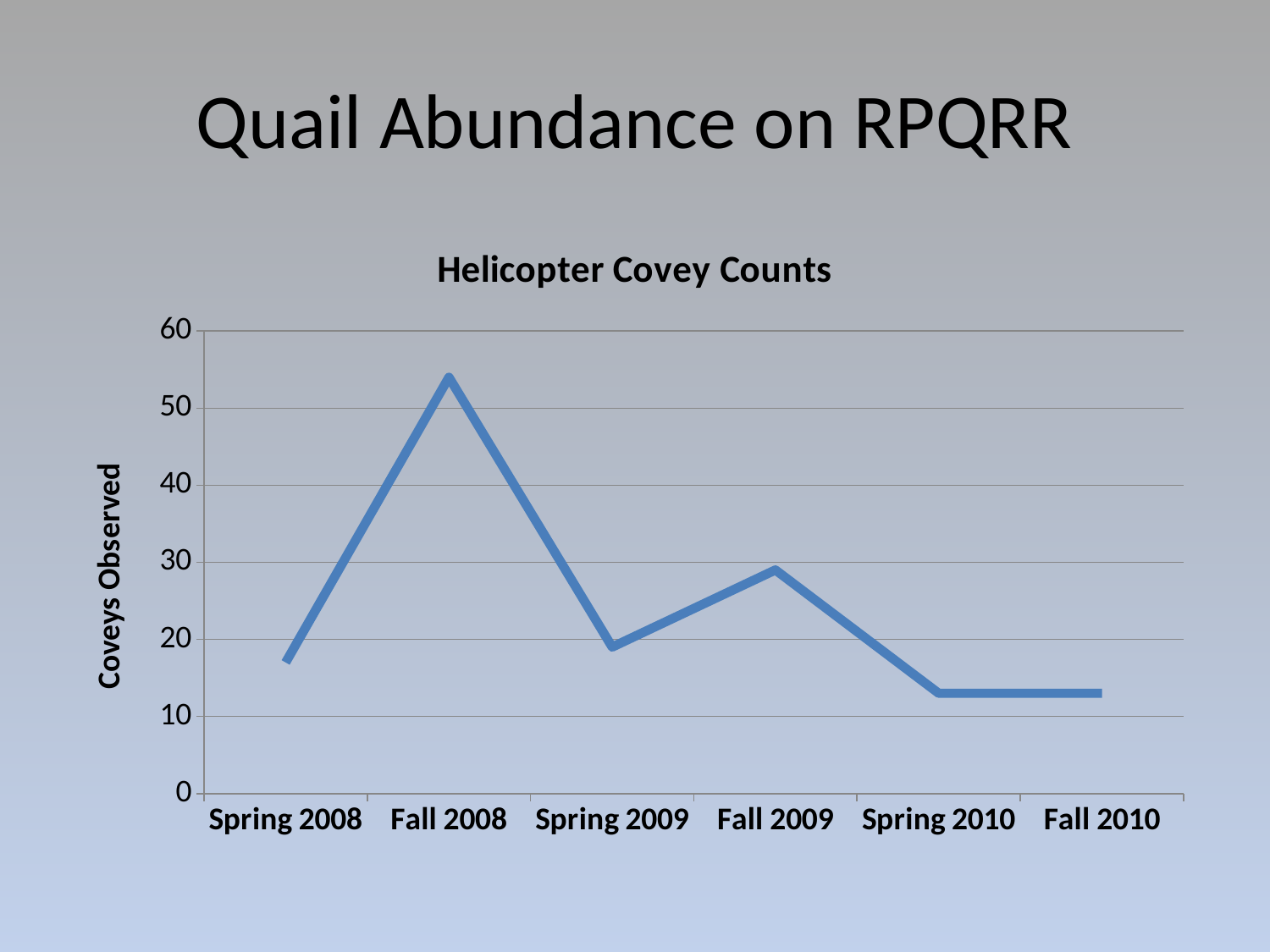
Do the coveys observed rise or fall from Fall 2009 to Spring 2010? fall Is the value for Spring 2010 greater or less than 10? greater What is the label on the vertical axis? Coveys Observed Is the value for Fall 2008 greater or less than 50? greater How many periods are plotted along the x axis? 6 What kind of chart is shown on the slide? line chart What is the title of the chart? Helicopter Covey Counts Which is larger, the value for Spring 2008 or the value for Fall 2009? Fall 2009 Is the value for Fall 2009 greater or less than 20? greater Which period has the highest number of coveys observed? Fall 2008 Which is larger, the value for Fall 2008 or the value for Spring 2009? Fall 2008